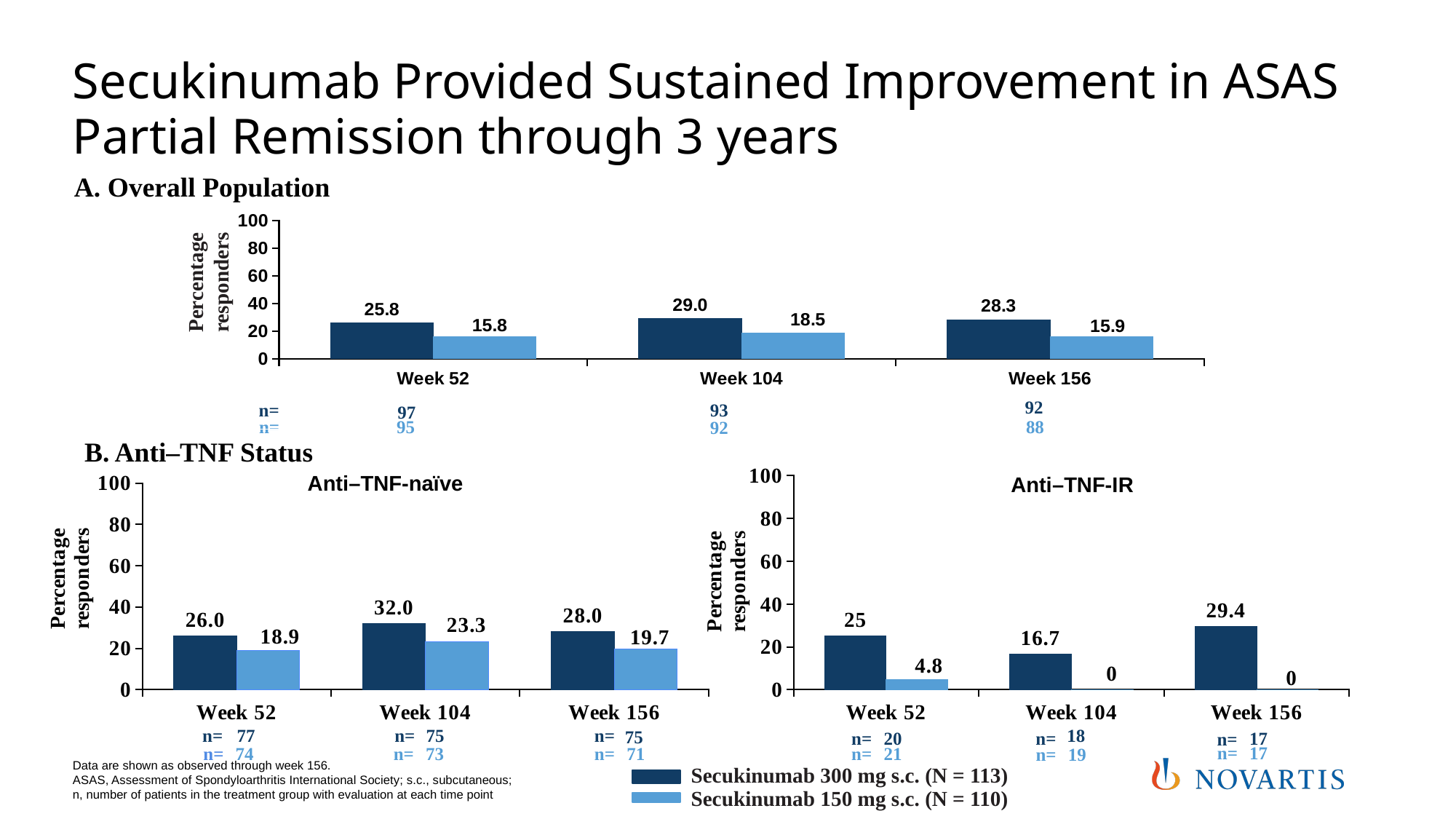
In the Overall Population chart, what is the value for Secukinumab 150 mg at Week 156? 15.9 In the Anti–TNF-IR chart, what is the difference between the Secukinumab 300 mg and 150 mg values at Week 104? 16.7 In the Overall Population chart, what is the difference between the Secukinumab 300 mg and 150 mg values at Week 52? 10.0 In the Overall Population chart, at which week is the Secukinumab 150 mg value highest? Week 104 In the Anti–TNF-naïve chart, what is the value for Secukinumab 150 mg at Week 104? 23.3 In the Anti–TNF-IR chart, what is the value for Secukinumab 150 mg at Week 52? 4.8 In the Anti–TNF-IR chart, what is the value for Secukinumab 300 mg at Week 156? 29.4 In the Anti–TNF-naïve chart, which is larger at Week 156: the Secukinumab 300 mg value or the Secukinumab 150 mg value? Secukinumab 300 mg How many series does the legend list? 2 In the Overall Population chart, what is the value for Secukinumab 300 mg at Week 104? 29.0 In the Anti–TNF-naïve chart, at which week is the Secukinumab 300 mg value lowest? Week 52 What kind of chart is the Overall Population chart? Bar chart